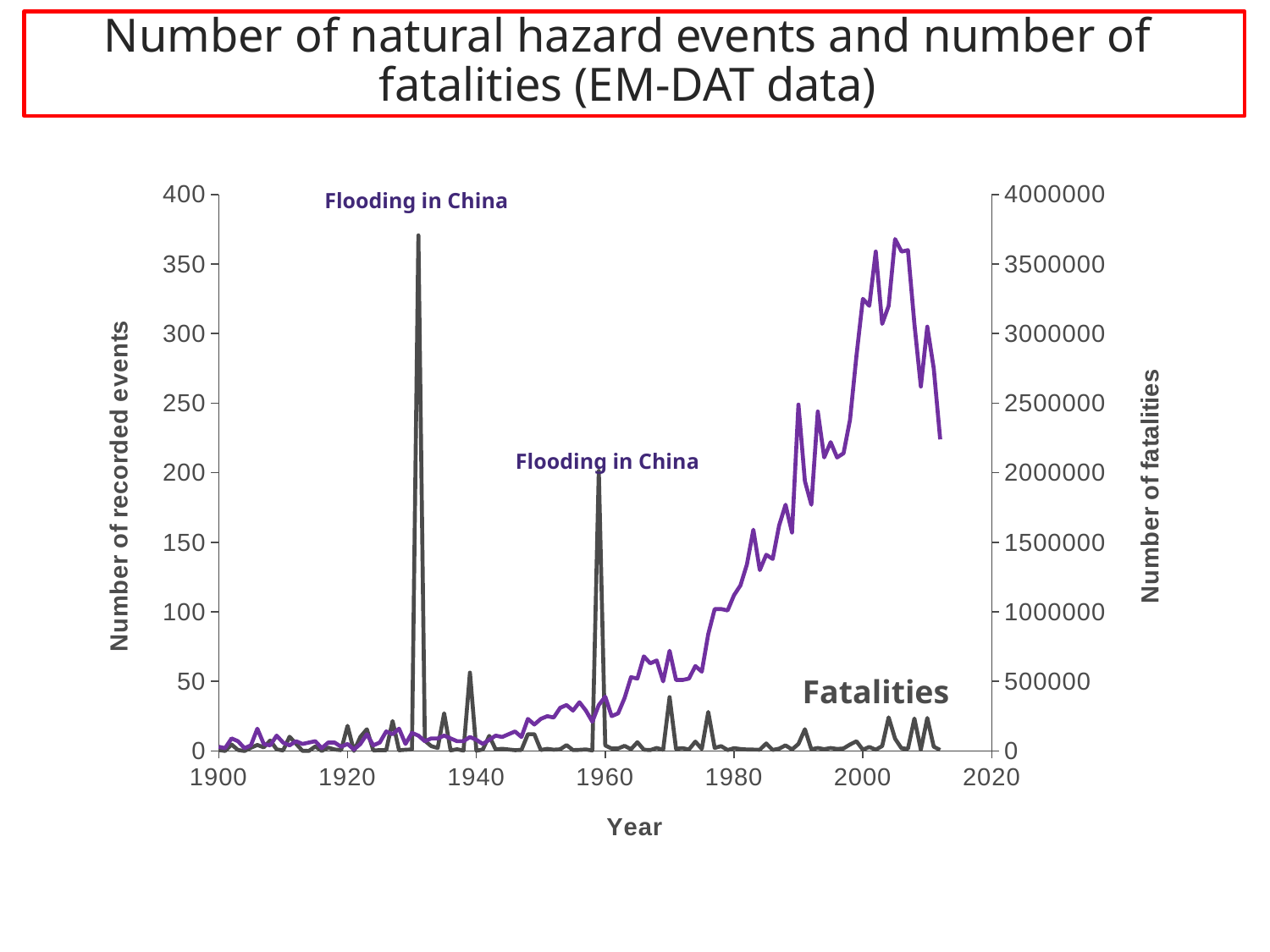
Is the number of recorded events in 1960 greater or less than 100? less What is the label of the left vertical axis? Number of recorded events Which of the two spikes annotated 'Flooding in China' is higher, the one around 1930 or the one around 1960? the one around 1930 How many data series are plotted on the chart? 2 What is the title of the chart on the slide? Number of natural hazard events and number of fatalities (EM-DAT data) Is the number of recorded events at its peak around 2004 greater or less than 300? greater Overall, does the number of recorded events rise or fall from 1900 to 2010? rise What event is annotated at the two large fatality spikes? Flooding in China Is the number of recorded events in 1980 greater or less than 50? greater What kind of chart is shown on the slide? line chart